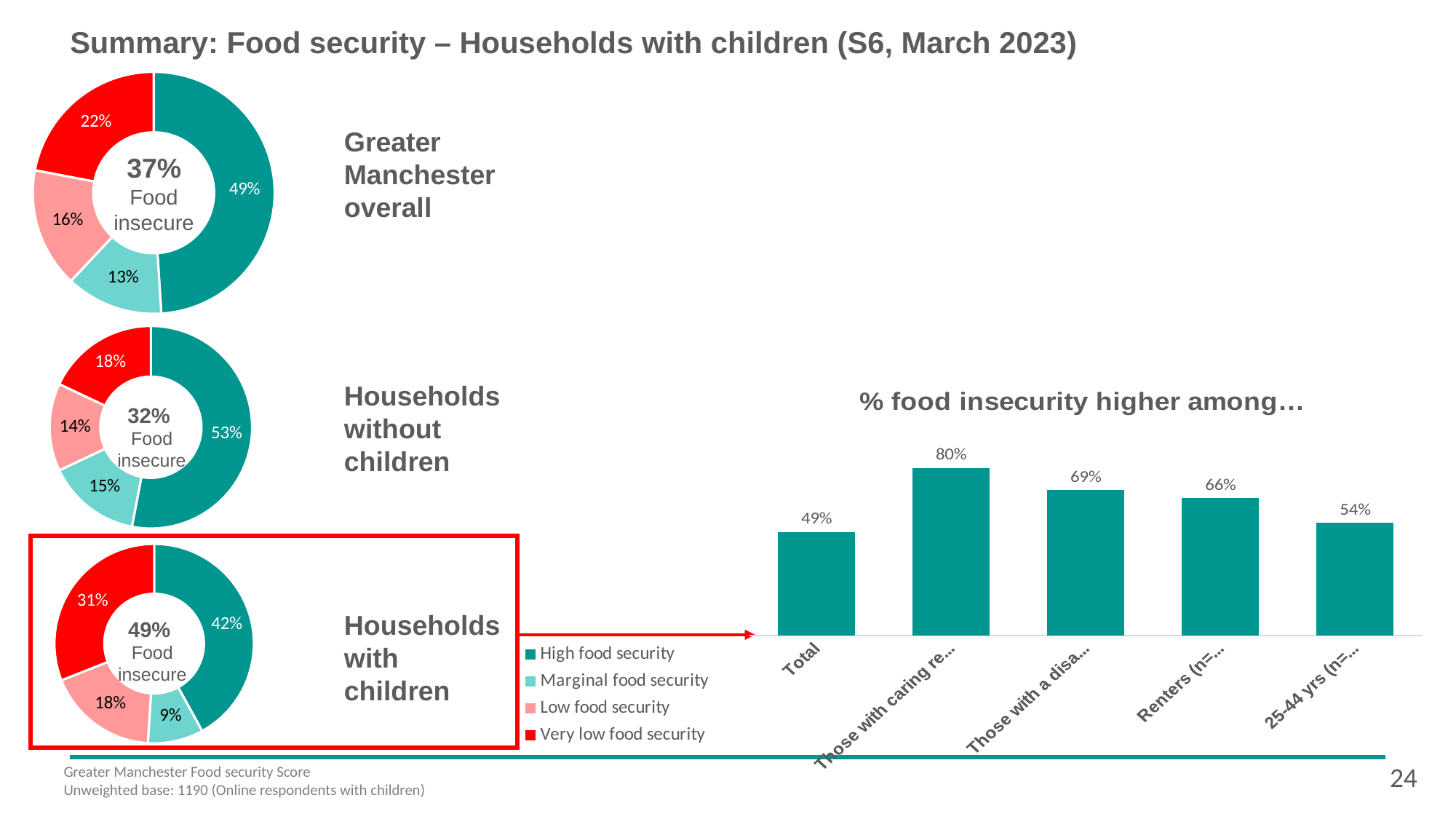
In the 'Households with children' donut chart, what percentage is shown for Marginal food security? 9% In the '% food insecurity higher among…' bar chart, what is the value for Renters? 66% In the 'Households with children' donut chart, which segment is the largest? High food security In the 'Households without children' donut chart, what is the difference between the High food security and Very low food security percentages? 35% In the 'Households with children' donut chart, what percentage is shown for Very low food security? 31% In the '% food insecurity higher among…' bar chart, what is the value for Total? 49% What is the 'Food insecure' percentage shown in the centre of the 'Households with children' donut chart? 49% In the '% food insecurity higher among…' bar chart, what is the highest value shown? 80% In the 'Households without children' donut chart, what percentage is shown for Low food security? 14% How many bars are in the '% food insecurity higher among…' bar chart? 5 In the 'Greater Manchester overall' donut chart, what percentage is shown for High food security? 49% In the 'Greater Manchester overall' donut chart, what percentage is shown for Very low food security? 22%